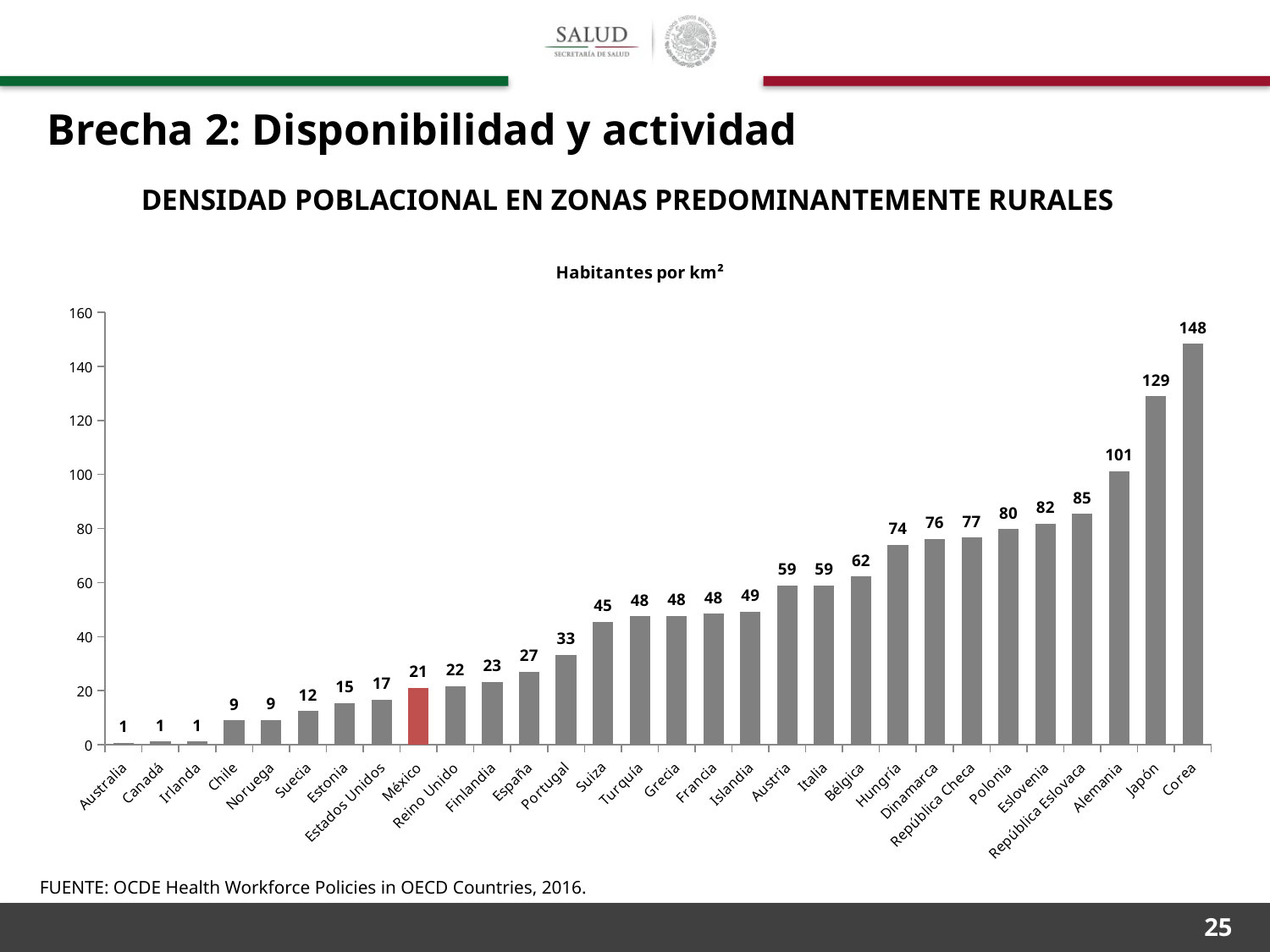
What is the value for Japón? 129 What is the value for México? 21 Which is larger, the value for Portugal or the value for Suiza? Suiza Do the values rise or fall from left to right along the x axis? rise What is the difference between the values for Alemania and México? 80 Which country's bar is highlighted in red? México What kind of chart is this? bar chart What is the difference between the values for Corea and Japón? 19 How many countries are shown on the chart? 30 Which country has the highest value? Corea Is the value for Hungría greater or less than 60? greater What is the value for Alemania? 101